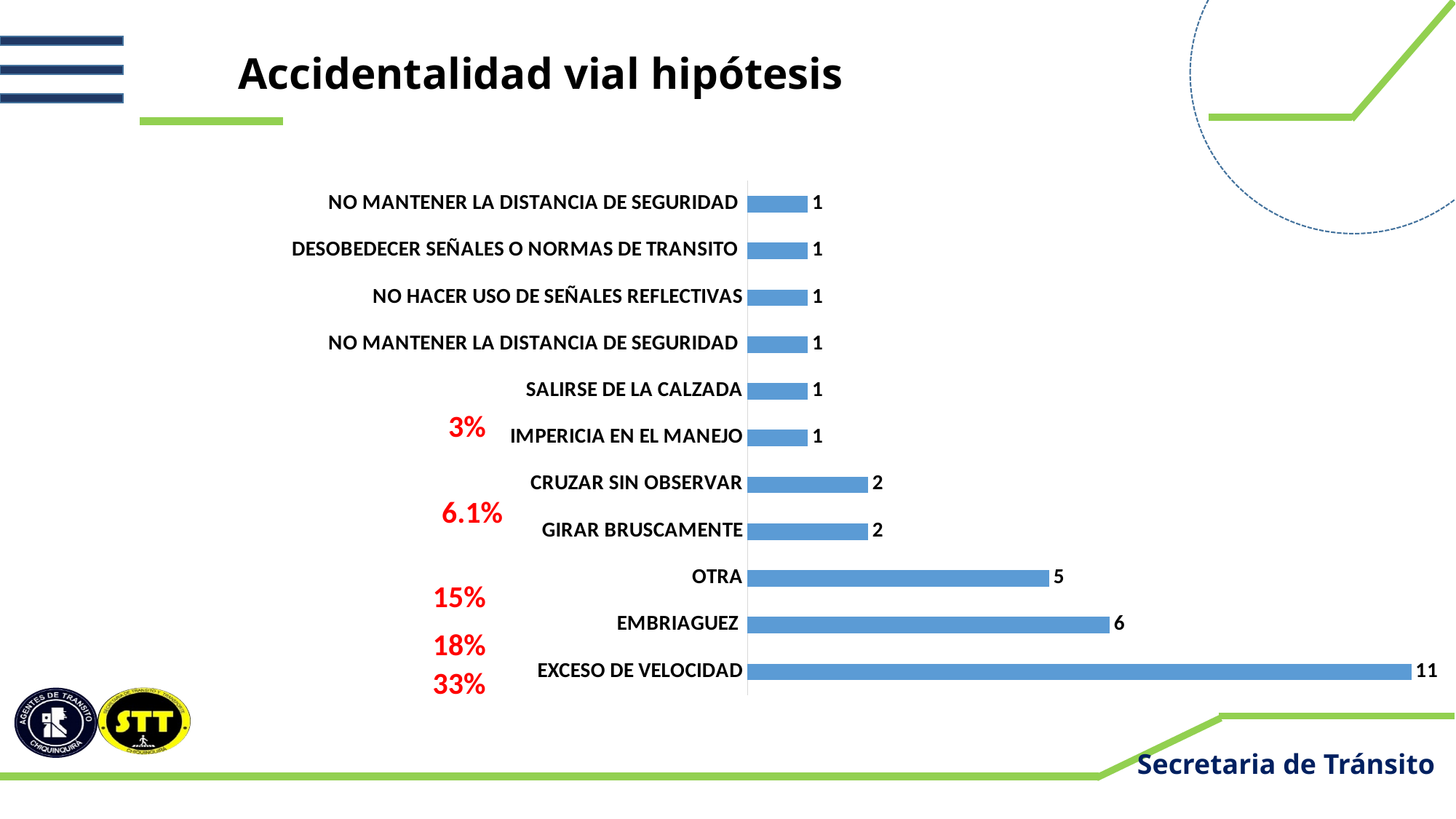
What is the value for OTRA? 5 What kind of chart is shown on the slide? bar chart What is the value for EXCESO DE VELOCIDAD? 11 What is the title of the slide containing the chart? Accidentalidad vial hipótesis What is the difference between the values for EXCESO DE VELOCIDAD and EMBRIAGUEZ? 5 Which category has the highest value? EXCESO DE VELOCIDAD How many categories are shown in the chart? 11 Which is larger, the value for EMBRIAGUEZ or the value for OTRA? EMBRIAGUEZ What is the value for IMPERICIA EN EL MANEJO? 1 What is the value for EMBRIAGUEZ? 6 What is the value for GIRAR BRUSCAMENTE? 2 What is the difference between the values for OTRA and CRUZAR SIN OBSERVAR? 3